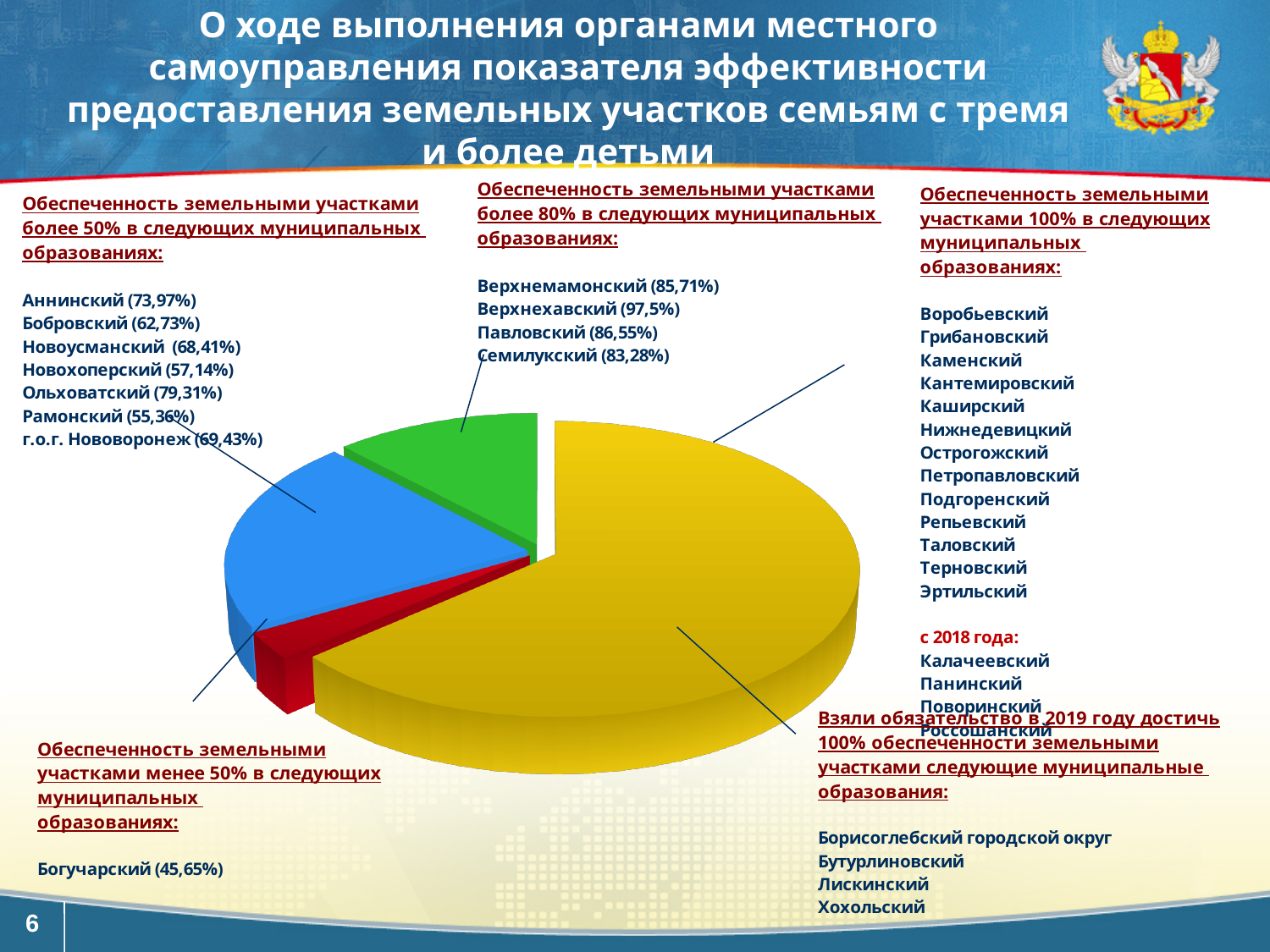
Does the yellow slice take up more or less than half of the pie? more Which group of municipalities does the smallest slice of the pie chart represent? Обеспеченность земельными участками менее 50% What colour is the slice linked to the group 'Обеспеченность земельными участками более 80%'? green What kind of chart is shown on the slide? pie chart Which slice is larger: the blue slice (более 50%) or the green slice (более 80%)? the blue slice (более 50%) How many slices does the pie chart have? 4 What colour is the slice linked to the group 'Обеспеченность земельными участками менее 50%'? red Which slice is larger: the yellow slice (100%) or the blue slice (более 50%)? the yellow slice (100%) Which group of municipalities does the largest slice of the pie chart represent? Обеспеченность земельными участками 100%